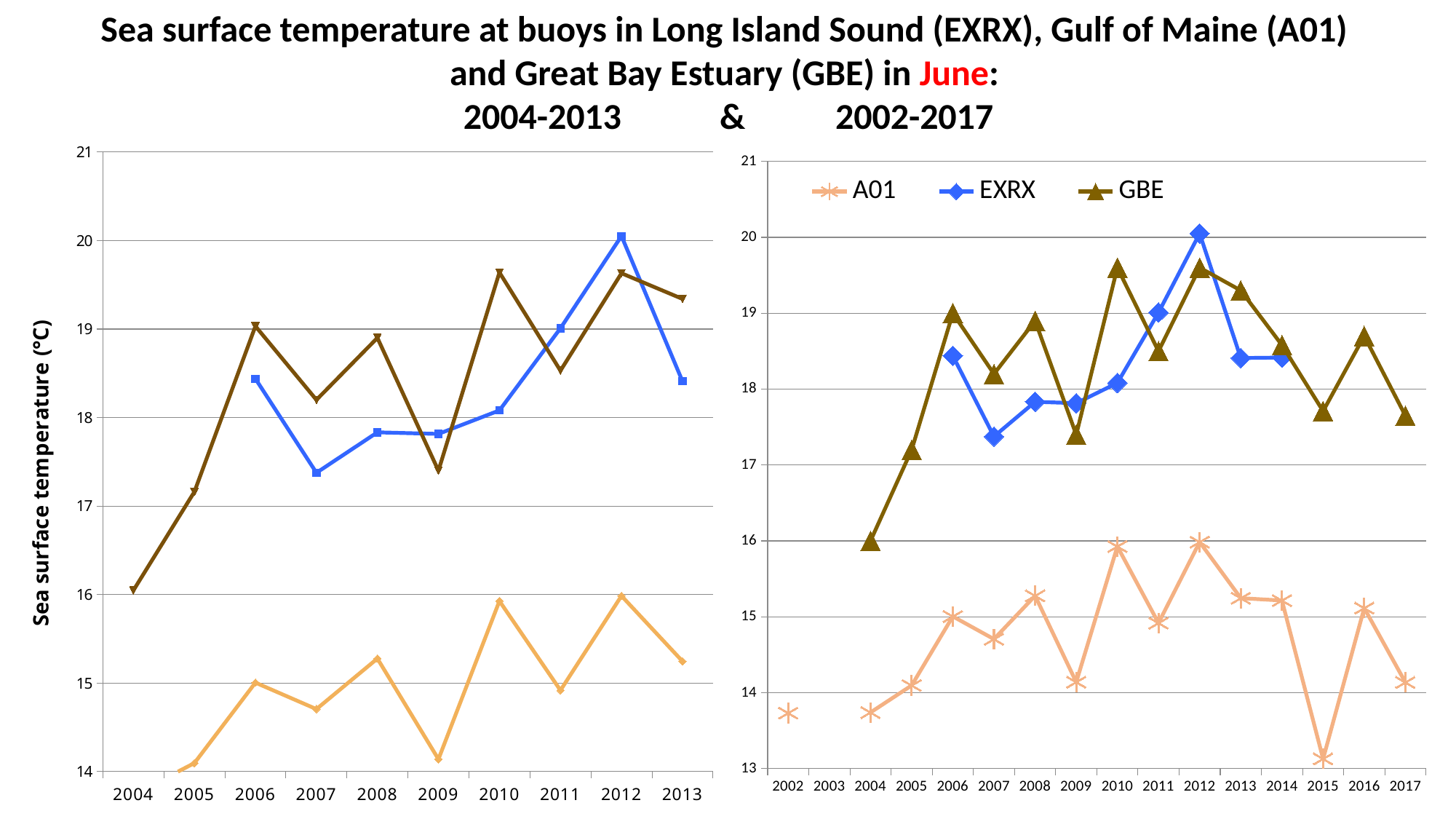
How many years are shown on the x axis of the left chart (2004-2013)? 10 On the right chart (2002-2017), is the A01 value for 2015 greater or less than 14? less How many series does the legend on the right chart (2002-2017) list? 3 On the right chart (2002-2017), in which year does the GBE series have its lowest value? 2004 Which month is highlighted in red in the slide title? June How many years are shown on the x axis of the right chart (2002-2017)? 16 What kind of chart is the left chart (2004-2013)? line chart On the right chart (2002-2017), in which year does the EXRX series reach its highest value? 2012 On the right chart (2002-2017), is the GBE value for 2010 greater or less than 19? greater On the right chart (2002-2017), which series has the higher value in 2006, GBE or EXRX? GBE On the right chart (2002-2017), in which year does the A01 series reach its lowest value? 2015 On the right chart (2002-2017), does the A01 series rise or fall from 2014 to 2015? fall